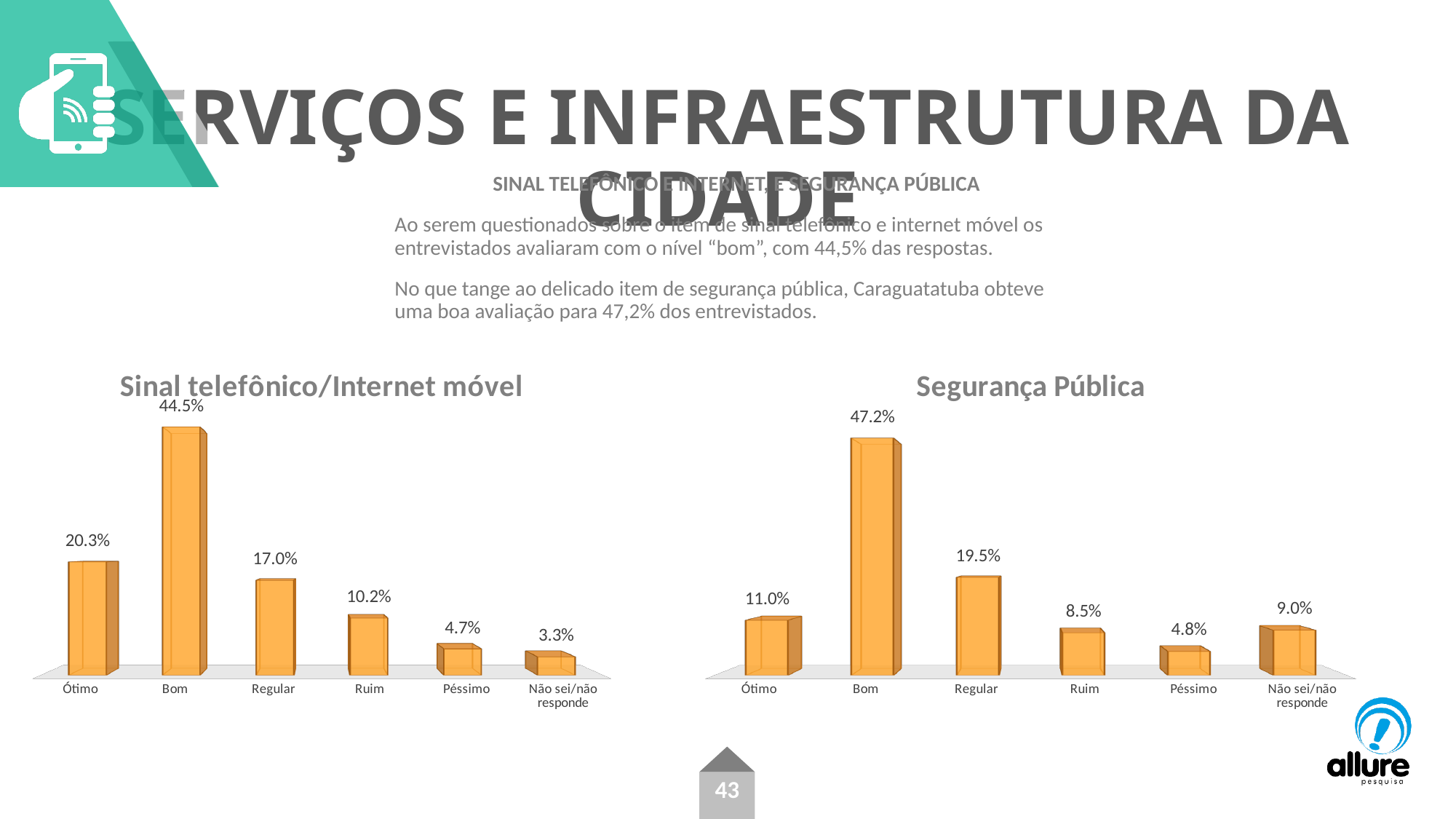
What is the title of the chart on the right side of the slide? Segurança Pública In the 'Sinal telefônico/Internet móvel' chart, which category has the lowest value? Não sei/não responde In the 'Segurança Pública' chart, which category has the lowest value? Péssimo In the 'Sinal telefônico/Internet móvel' chart, what is the value for Bom? 44.5% In the 'Sinal telefônico/Internet móvel' chart, what is the difference between Bom and Ótimo? 24.2% In the 'Segurança Pública' chart, what is the difference between Ótimo and Não sei/não responde? 2.0% How many categories does the 'Segurança Pública' chart show? 6 In the 'Sinal telefônico/Internet móvel' chart, what is the value for Não sei/não responde? 3.3% In the 'Segurança Pública' chart, what is the value for Regular? 19.5% In the 'Segurança Pública' chart, which category has the highest value? Bom In the 'Sinal telefônico/Internet móvel' chart, which is larger, Regular or Ruim? Regular What kind of chart is the 'Sinal telefônico/Internet móvel' chart? Bar chart